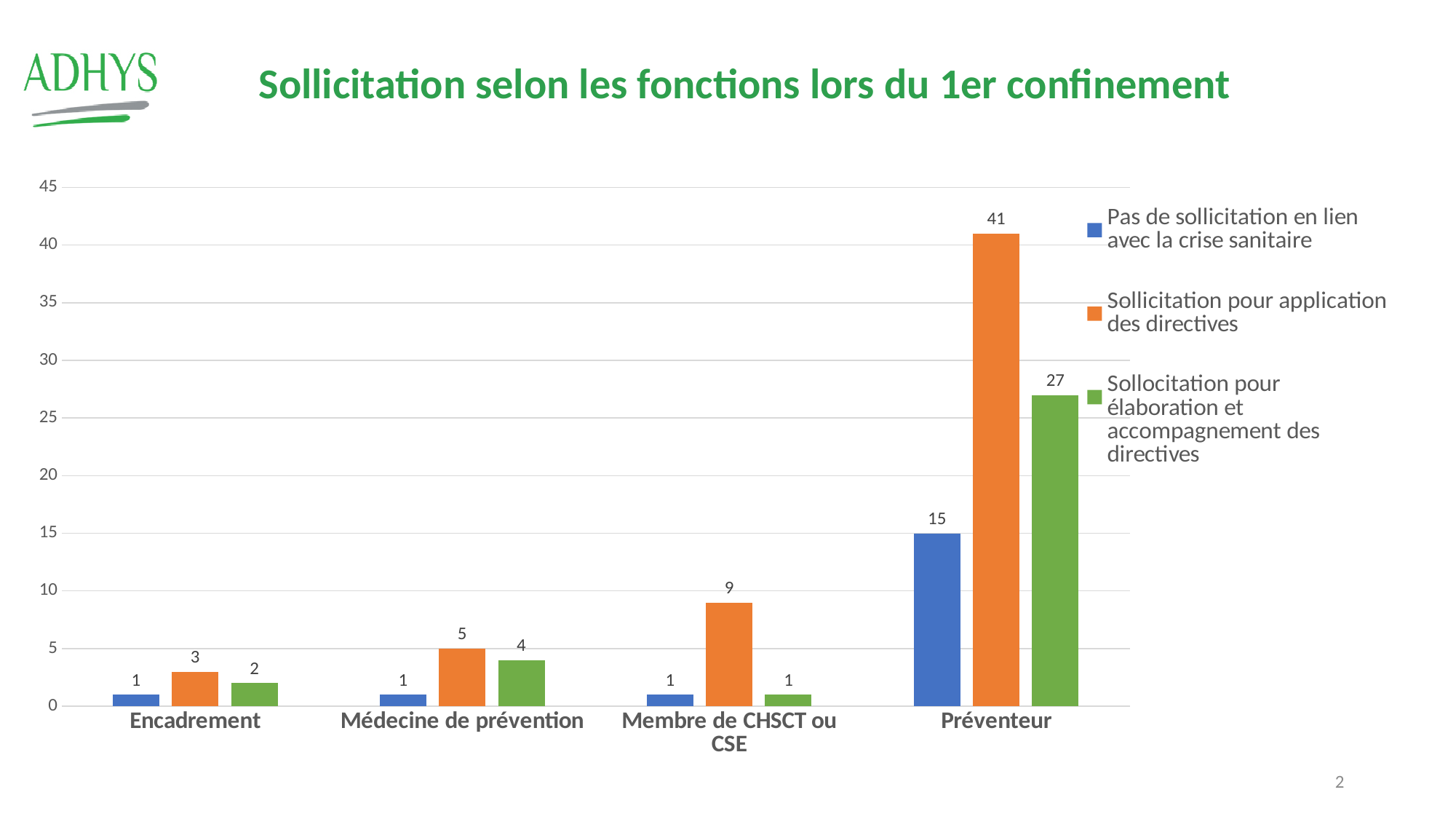
How many series does the legend list? 3 What is the value for Membre de CHSCT ou CSE in the 'Sollicitation pour application des directives' series? 9 What kind of chart is shown on the slide? Bar chart How many categories are shown on the x axis? 4 Which category has the lowest value in the 'Sollocitation pour élaboration et accompagnement des directives' series? Membre de CHSCT ou CSE What is the value for Préventeur in the 'Sollicitation pour application des directives' series? 41 Is the value for Préventeur in the 'Sollicitation pour application des directives' series greater or less than 40? greater For Encadrement, which is larger: the 'Sollicitation pour application des directives' value or the 'Sollocitation pour élaboration et accompagnement des directives' value? Sollicitation pour application des directives What is the value for Médecine de prévention in the 'Sollocitation pour élaboration et accompagnement des directives' series? 4 Which category has the highest value in the 'Sollicitation pour application des directives' series? Préventeur What is the difference between the 'Sollicitation pour application des directives' value and the 'Sollocitation pour élaboration et accompagnement des directives' value for Préventeur? 14 What is the value for Préventeur in the 'Pas de sollicitation en lien avec la crise sanitaire' series? 15